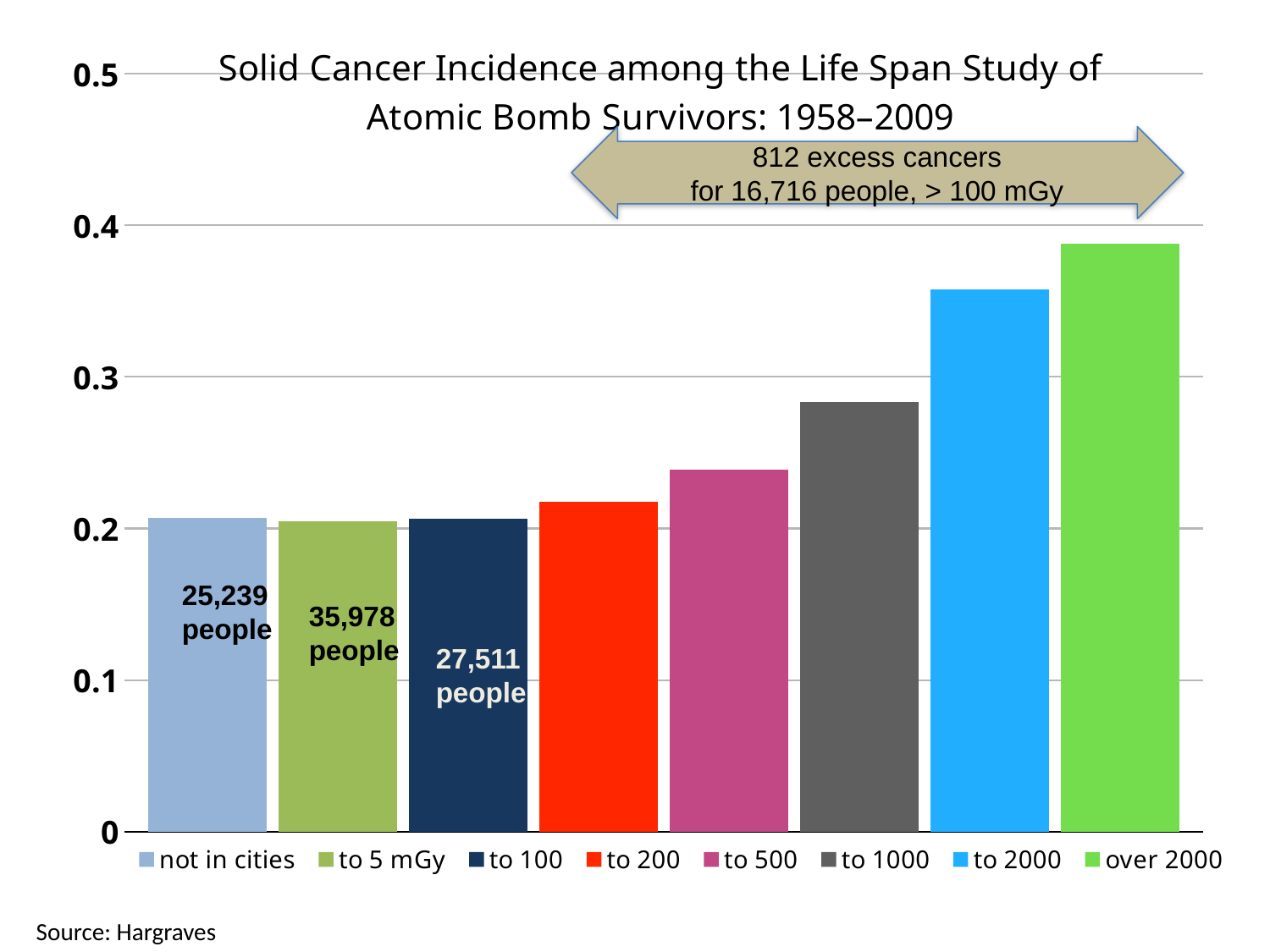
Is the value for 'over 2000' greater or less than 0.3? greater How many people are labelled on the 'to 5 mGy' bar? 35,978 people Is the value for 'to 1000' greater or less than 0.3? less What is the title of the chart? Solid Cancer Incidence among the Life Span Study of Atomic Bomb Survivors: 1958–2009 Is the value for 'to 2000' greater or less than 0.3? greater Which category has the highest bar? over 2000 How many entries does the legend list? 8 What kind of chart is shown on the slide? bar chart Do the bar values generally rise or fall moving from left to right across the categories? rise How many bars (categories) are plotted in the chart? 8 Which is larger, the value for 'to 2000' or the value for 'to 500'? to 2000